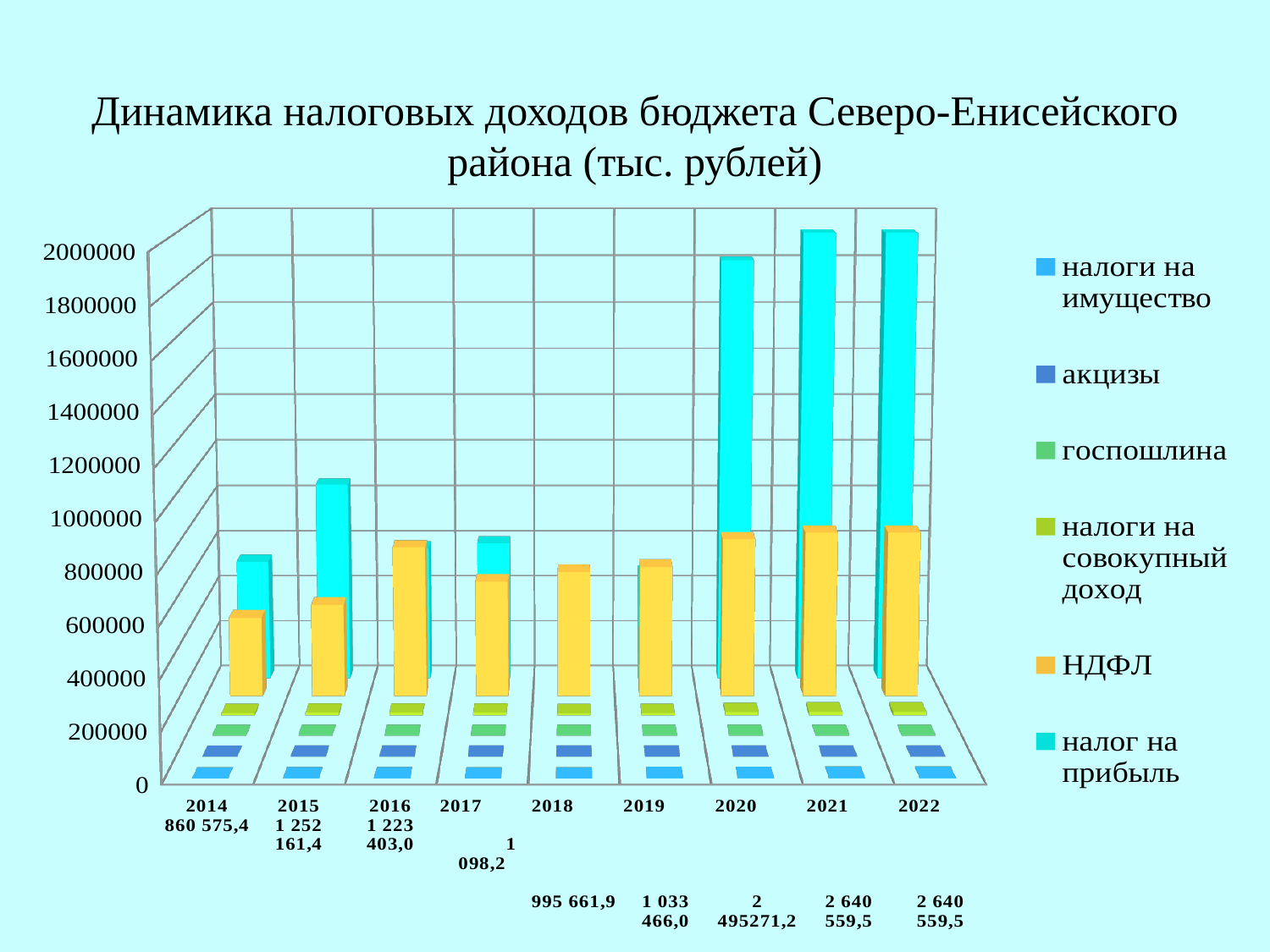
How many years are shown along the x axis of the chart? 9 Is the value of налог на прибыль for 2021 greater or less than 1400000? greater Which is larger, налог на прибыль in 2020 or налог на прибыль in 2015? 2020 Which is larger, НДФЛ in 2021 or НДФЛ in 2014? 2021 How many series does the legend list? 6 Does НДФЛ generally rise or fall from 2014 to 2022? rise Is the value of налог на прибыль for 2015 greater or less than 600000? greater What total value is printed under the 2021 category label? 2 640 559,5 Is the value of налоги на имущество for 2022 greater or less than 200000? less What is the title of the chart? Динамика налоговых доходов бюджета Северо-Енисейского района (тыс. рублей) What kind of chart is shown on the slide? bar chart